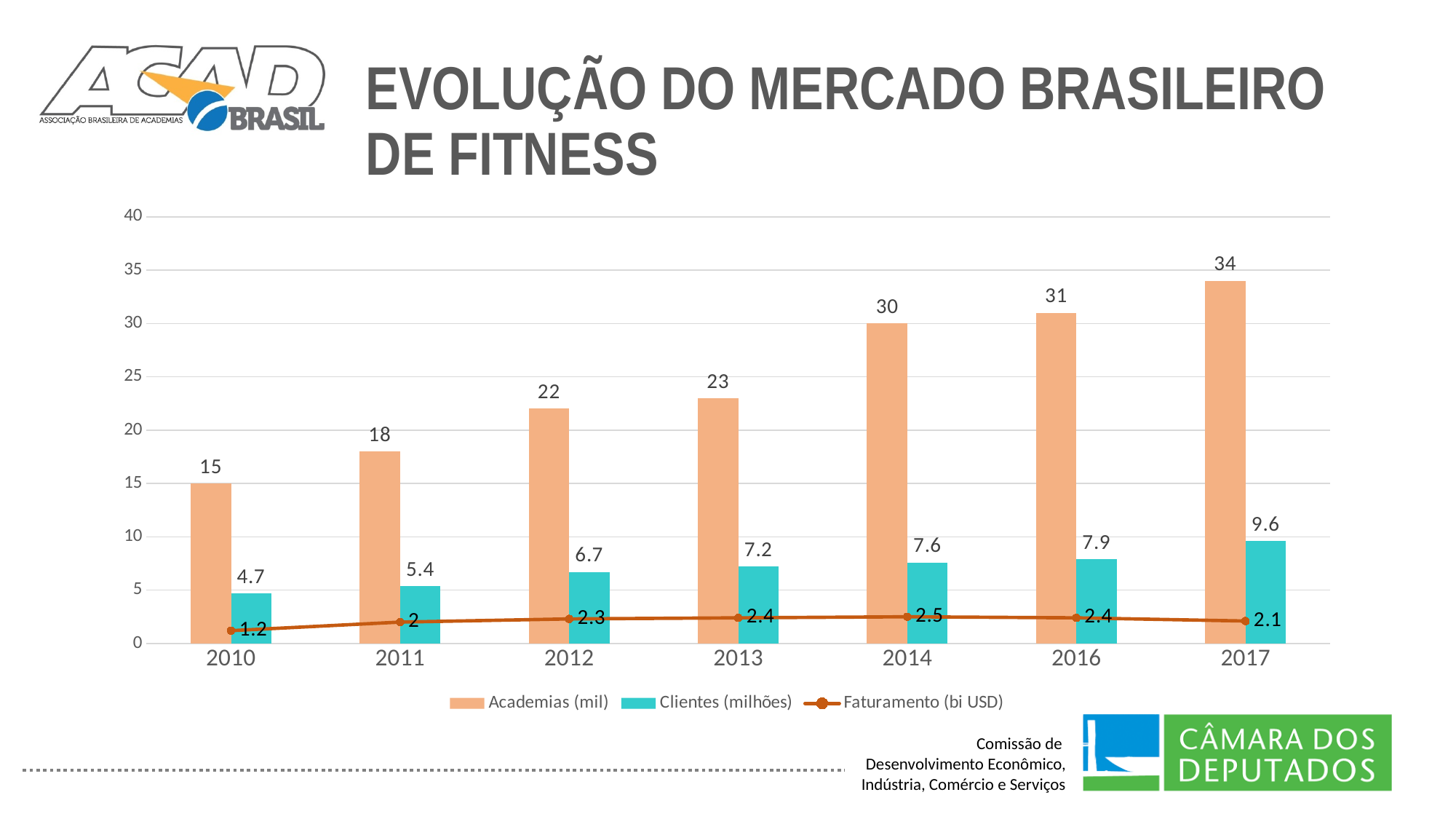
What is the difference between the Academias (mil) values for 2017 and 2010? 19 Is the value for Academias (mil) in 2013 greater or less than 20? greater Which year has the highest value for Academias (mil)? 2017 How many series does the legend list? 3 Which series is plotted as a line rather than bars? Faturamento (bi USD) Which is larger: Faturamento (bi USD) in 2014 or in 2017? 2014 What is the value of Faturamento (bi USD) in 2010? 1.2 What is the value of Academias (mil) in 2014? 30 Do the Academias (mil) values rise or fall from 2010 to 2017? rise How many years are shown on the x axis? 7 Which year has the lowest value for Clientes (milhões)? 2010 What is the value of Clientes (milhões) in 2012? 6.7